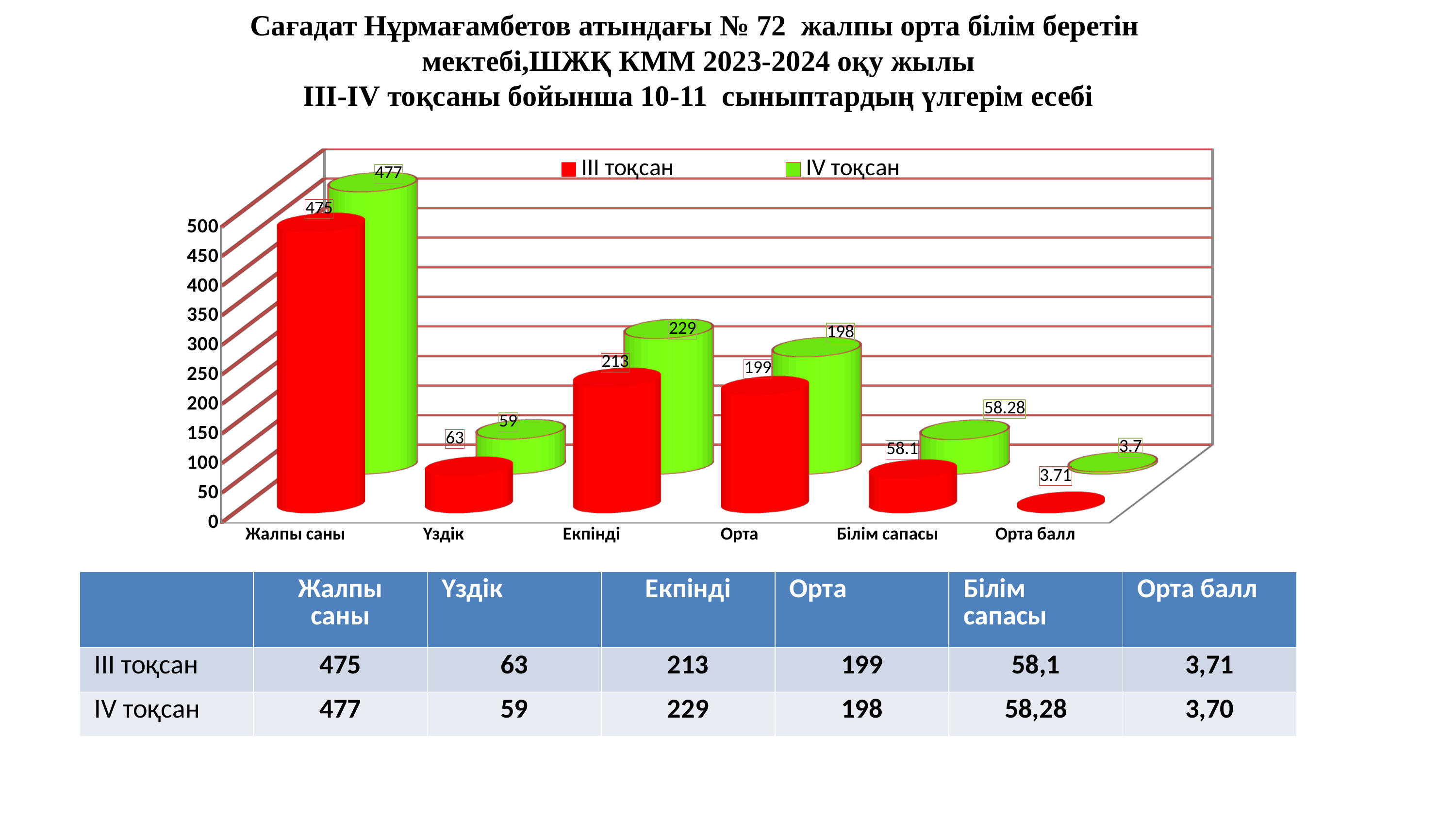
Which colour represents the IV тоқсан series in the chart? Green How many categories are shown on the x axis of the chart? 6 What kind of chart is shown on the slide? Bar chart What is the value for Орта балл in the III тоқсан series? 3.71 Which category has the highest value in the IV тоқсан series? Жалпы саны Which category has the lowest value in the III тоқсан series? Орта балл What is the value for Екпінді in the IV тоқсан series? 229 What is the difference between the IV тоқсан and III тоқсан values for Екпінді? 16 What is the value for Жалпы саны in the III тоқсан series? 475 How many series does the chart legend list? 2 Which is larger for Үздік: the III тоқсан value or the IV тоқсан value? III тоқсан What is the value for Білім сапасы in the IV тоқсан series? 58.28